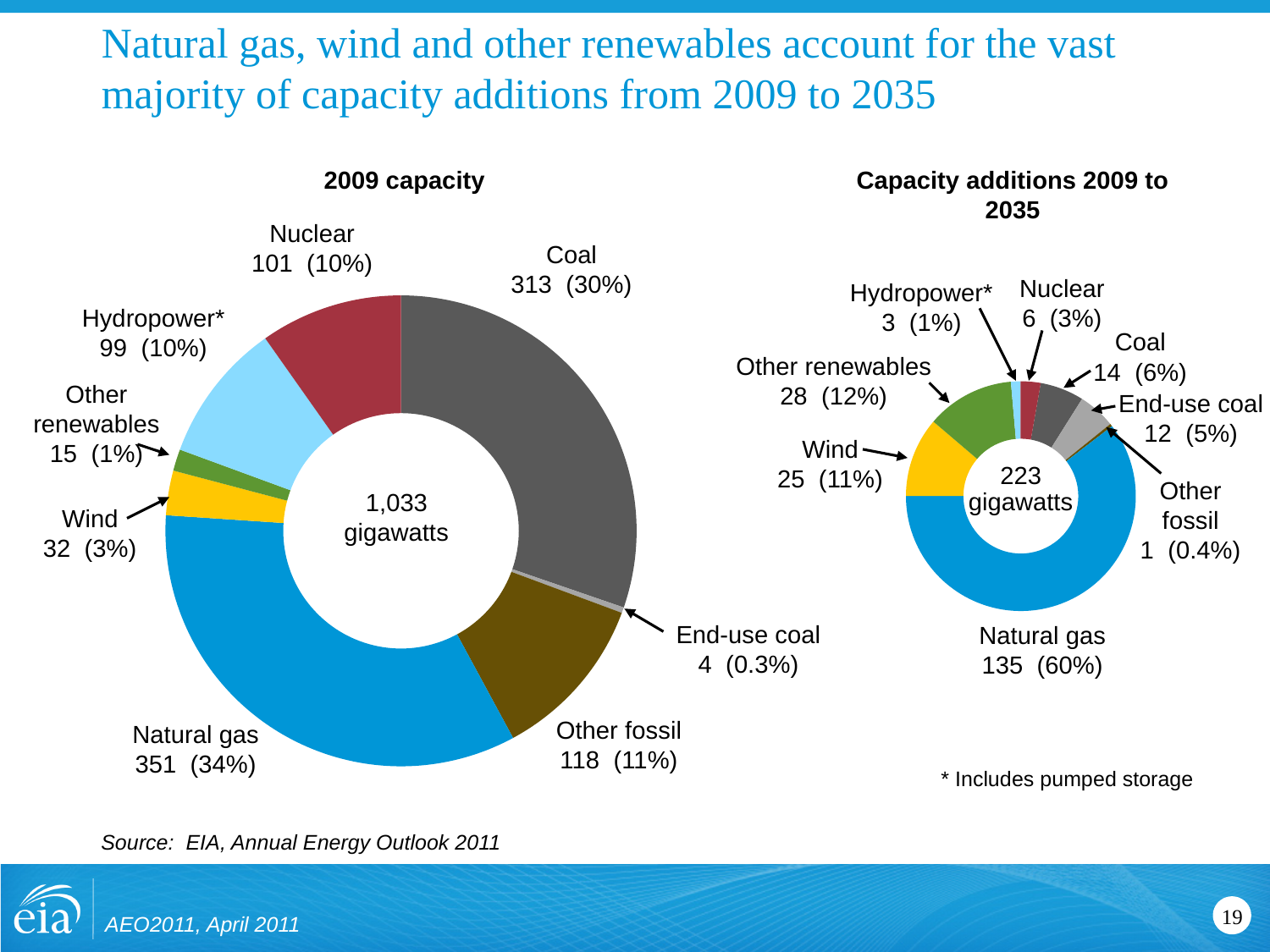
In the '2009 capacity' chart, what is the difference between Coal and Nuclear? 212 What total is shown in the centre of the 'Capacity additions 2009 to 2035' chart? 223 gigawatts In the 'Capacity additions 2009 to 2035' chart, what share of the total does Natural gas account for? 60% In the 'Capacity additions 2009 to 2035' chart, what is the value for Wind? 25 (11%) In the '2009 capacity' chart, which category has the largest value? Natural gas What is the title of the chart on the left of the slide? 2009 capacity What kind of chart is the 'Capacity additions 2009 to 2035' chart? Pie chart (doughnut) In the 'Capacity additions 2009 to 2035' chart, which is larger, Other renewables or Coal? Other renewables In the 'Capacity additions 2009 to 2035' chart, which category has the smallest value? Other fossil In the '2009 capacity' chart, what share of the total does Hydropower account for? 10% In the '2009 capacity' chart, what is the value for Natural gas? 351 (34%) How many categories are shown in the '2009 capacity' chart? 8